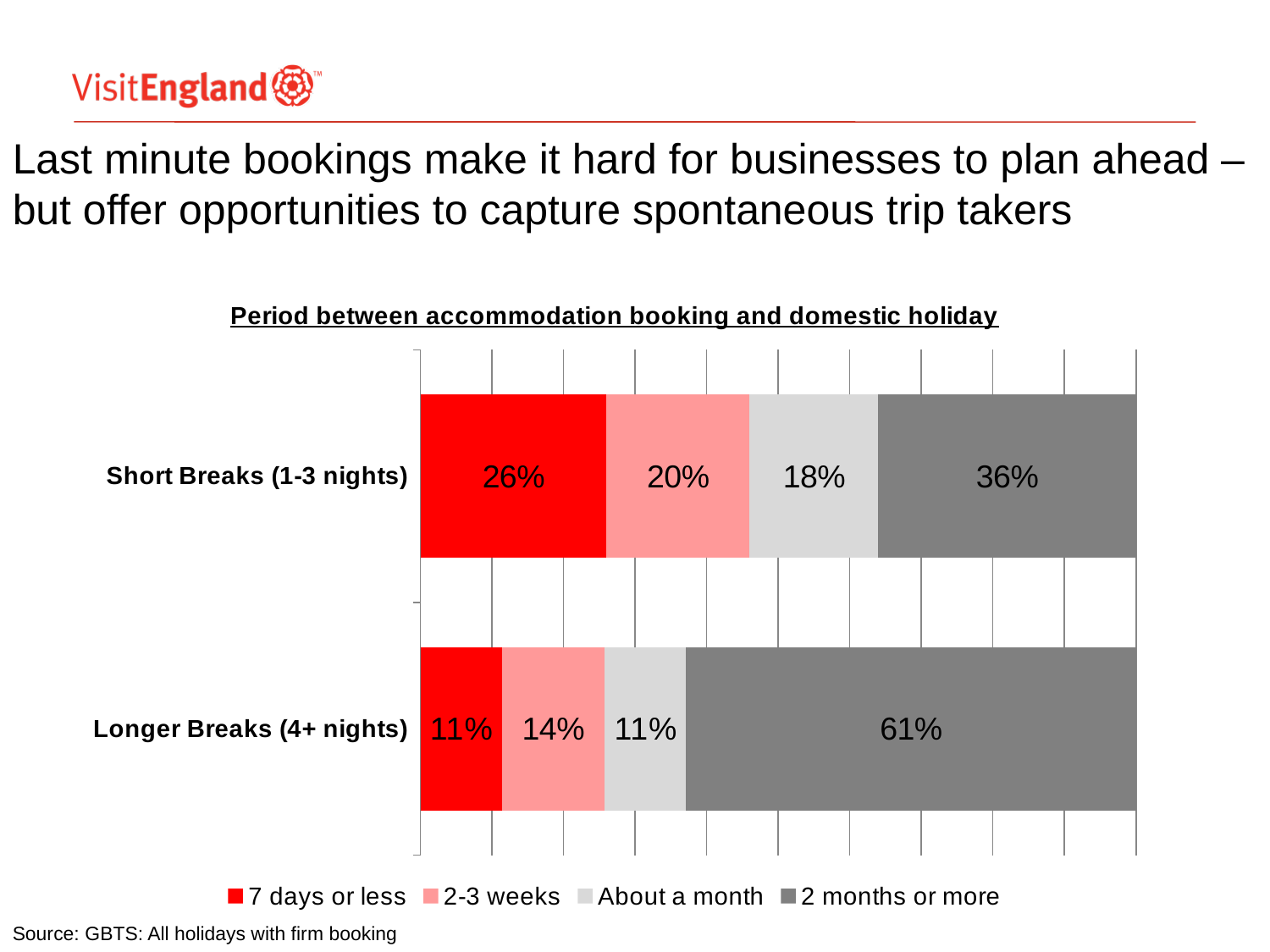
What percentage of Longer Breaks (4+ nights) are booked 2 months or more in advance? 61% Which booking period has the largest share for Short Breaks (1-3 nights)? 2 months or more How many series does the legend list? 4 What is the value for About a month for Short Breaks (1-3 nights)? 18% What is the title of the chart? Period between accommodation booking and domestic holiday What percentage of Short Breaks (1-3 nights) are booked 7 days or less before the holiday? 26% How many categories (bars) are shown in the chart? 2 What is the difference between the 2 months or more share for Longer Breaks (4+ nights) and for Short Breaks (1-3 nights)? 25% What is the value for 2-3 weeks for Longer Breaks (4+ nights)? 14% Which booking period has the smallest share for Short Breaks (1-3 nights)? About a month What kind of chart is shown on the slide? Stacked bar chart Which category has the larger share booked 7 days or less: Short Breaks (1-3 nights) or Longer Breaks (4+ nights)? Short Breaks (1-3 nights)